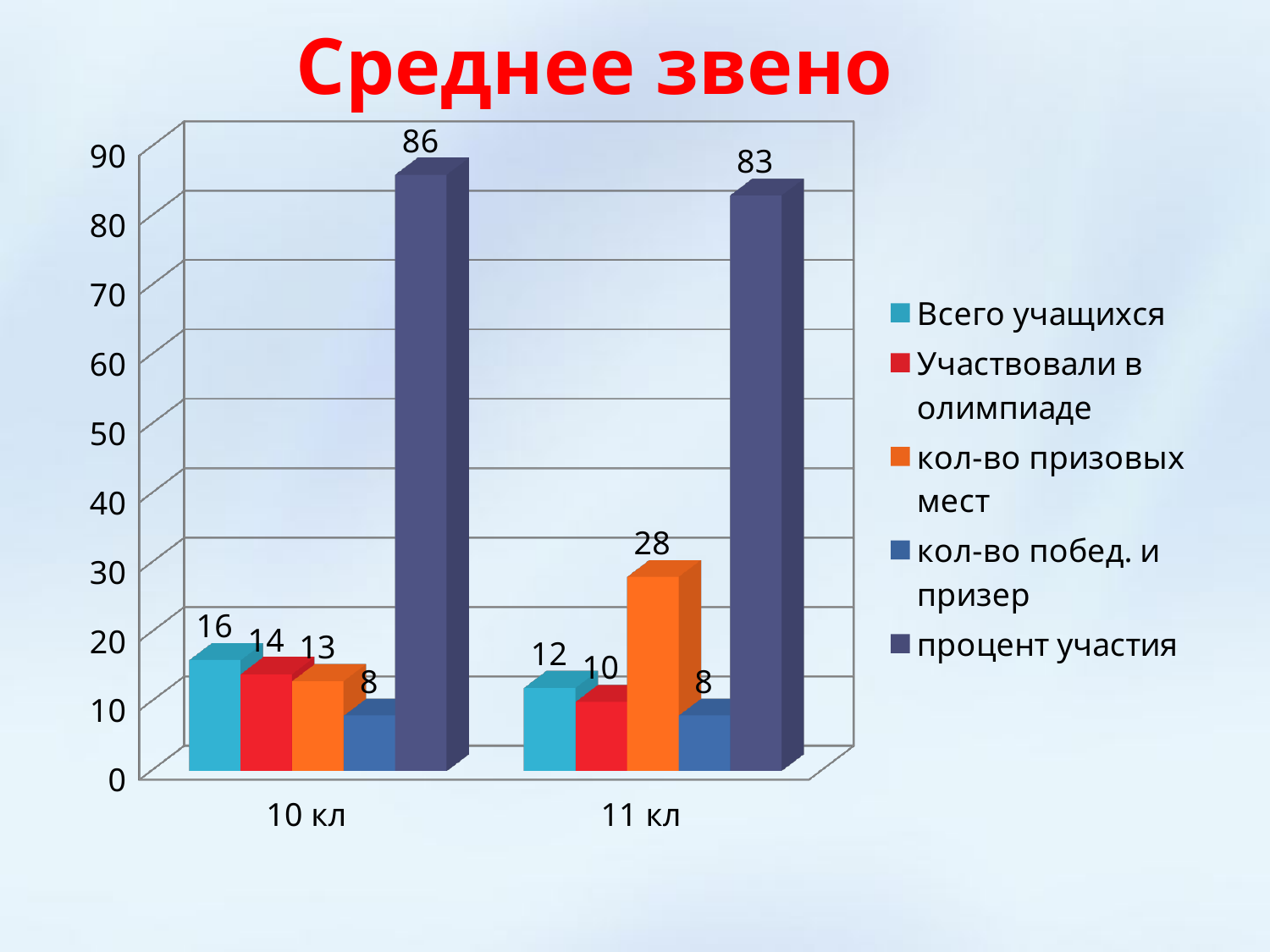
What is the value of 'процент участия' for 11 кл? 83 What is the difference between 'Всего учащихся' for 10 кл and for 11 кл? 4 How many series does the legend list? 5 How many categories are shown on the x axis? 2 Which series has the lowest value for 11 кл? кол-во побед. и призер What is the title of the slide? Среднее звено What is the value of 'Всего учащихся' for 10 кл? 16 Which category has the higher value for 'процент участия', 10 кл or 11 кл? 10 кл What is the difference between 'кол-во призовых мест' for 11 кл and for 10 кл? 15 What is the value of 'Участвовали в олимпиаде' for 10 кл? 14 What is the value of 'кол-во призовых мест' for 11 кл? 28 What kind of chart is shown on the slide? bar chart